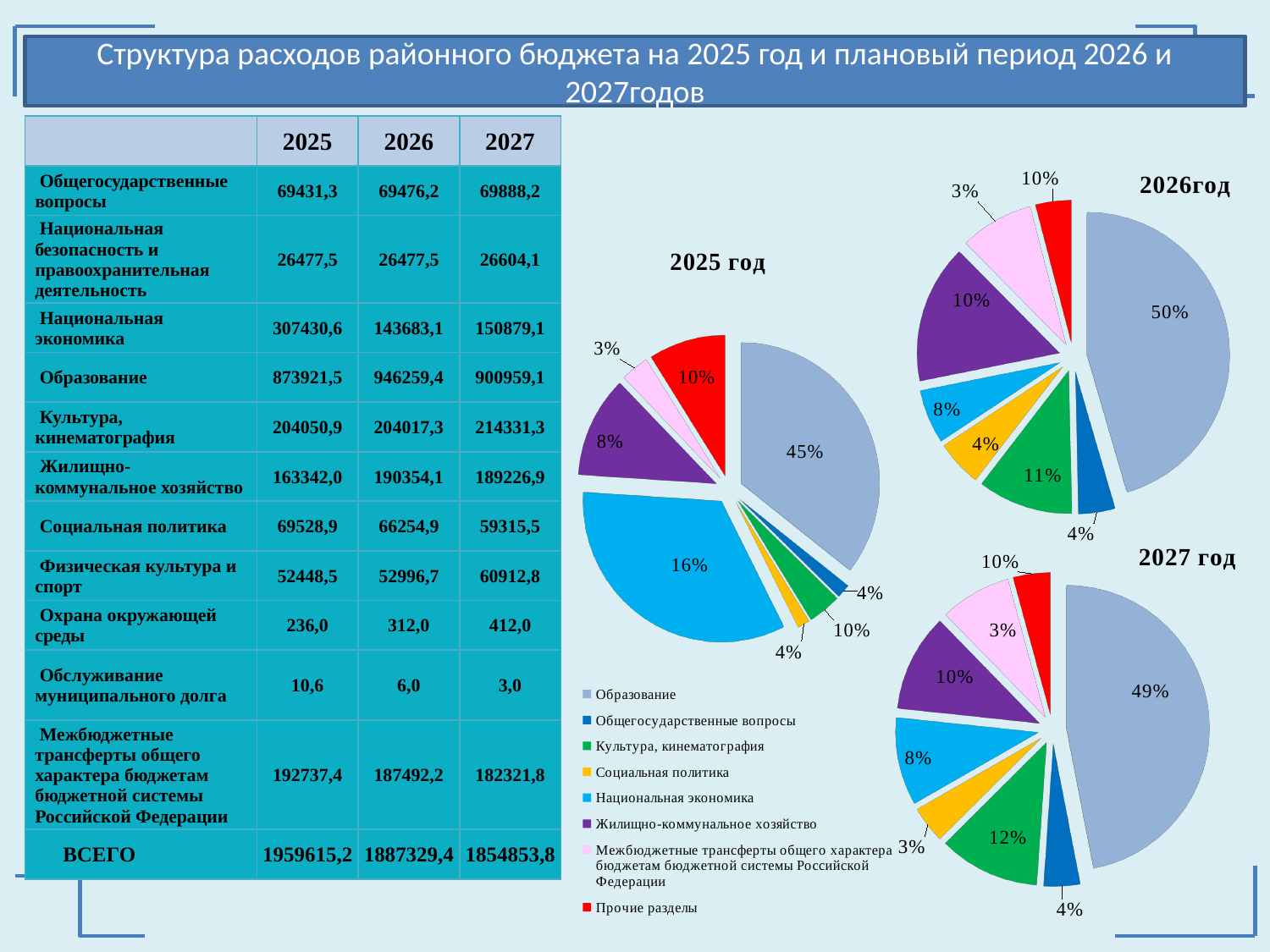
In the 2025 год pie chart, what share does Национальная экономика have? 16% In the 2027 год pie chart, what share does Культура, кинематография have? 12% In the 2025 год pie chart, what is the difference between the share of Образование and the share of Национальная экономика? 29% In the 2026год pie chart, what share does Образование have? 50% In the 2025 год pie chart, what share does Образование have? 45% In the 2026год pie chart, which category has the largest share? Образование In the 2027 год pie chart, what share does Образование have? 49% What kind of charts are shown on the slide? Pie charts How many pie charts are on the slide? 3 How many entries does the legend list for the pie charts? 8 In the 2025 год pie chart, which is larger: the share of Национальная экономика or the share of Жилищно-коммунальное хозяйство? Национальная экономика Which legend entry is shown in red in the pie charts? Прочие разделы